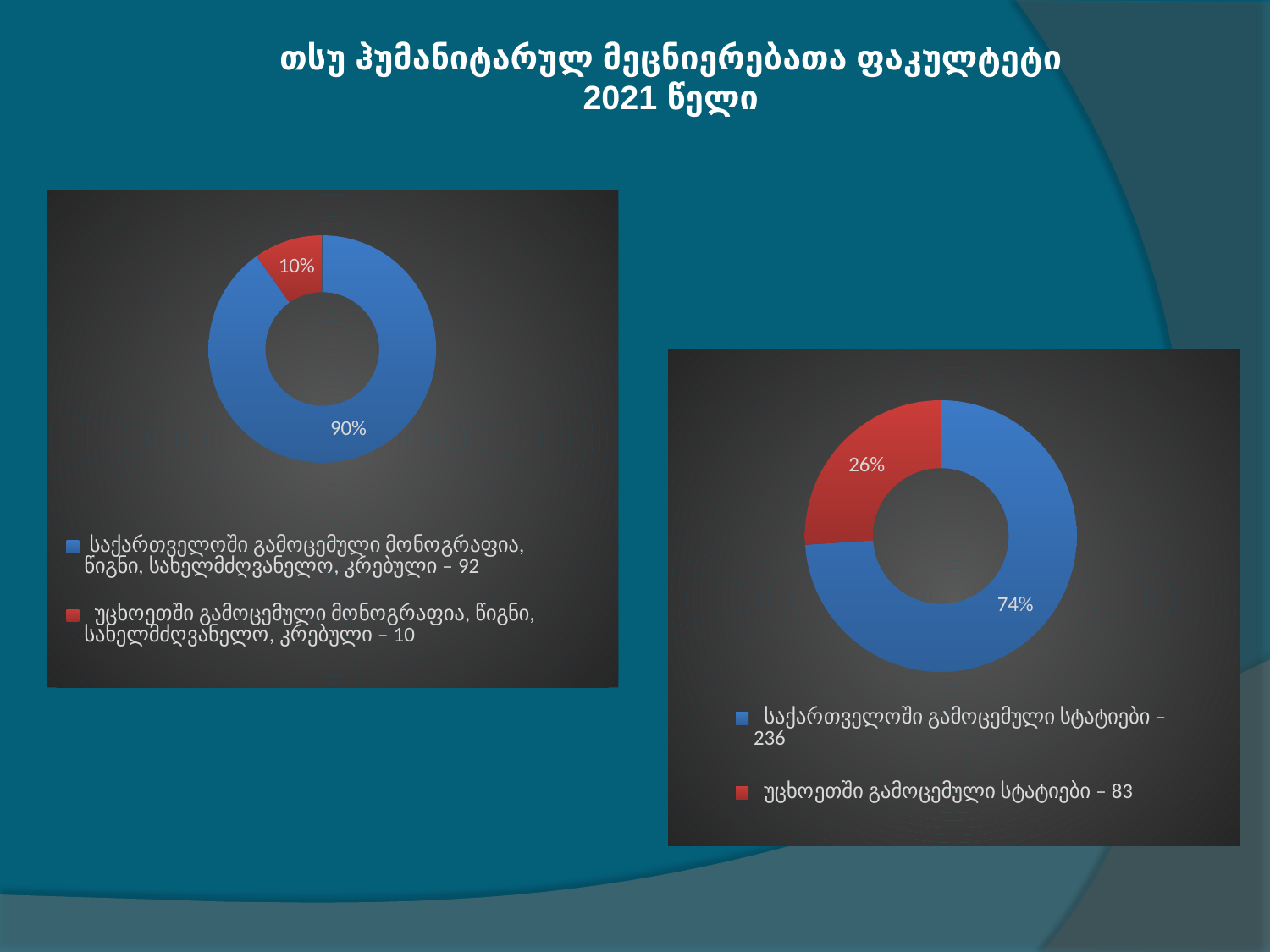
In the chart on the left, what number is given in the legend for საქართველოში გამოცემული მონოგრაფია, წიგნი, სახელმძღვანელო, კრებული? 92 In the chart on the left, what share of the doughnut does the red slice (უცხოეთში გამოცემული მონოგრაფია, წიგნი, სახელმძღვანელო, კრებული) take? 10% In the chart on the left, what number is given in the legend for უცხოეთში გამოცემული მონოგრაფია, წიგნი, სახელმძღვანელო, კრებული? 10 What kind of chart is the chart on the left of the slide? doughnut chart In the chart on the left, how many slices does the doughnut have? 2 In the chart on the right, what share of the doughnut does the blue slice (საქართველოში გამოცემული სტატიები) take? 74% In the chart on the right, what share of the doughnut does the red slice (უცხოეთში გამოცემული სტატიები) take? 26% In the chart on the right, what is the difference between the number of საქართველოში გამოცემული სტატიები and უცხოეთში გამოცემული სტატიები? 153 In the chart on the right, what number is given in the legend for უცხოეთში გამოცემული სტატიები? 83 In the chart on the right, which slice is larger: the blue one (საქართველოში გამოცემული სტატიები) or the red one (უცხოეთში გამოცემული სტატიები)? the blue one (საქართველოში გამოცემული სტატიები) In the chart on the right, what number is given in the legend for საქართველოში გამოცემული სტატიები? 236